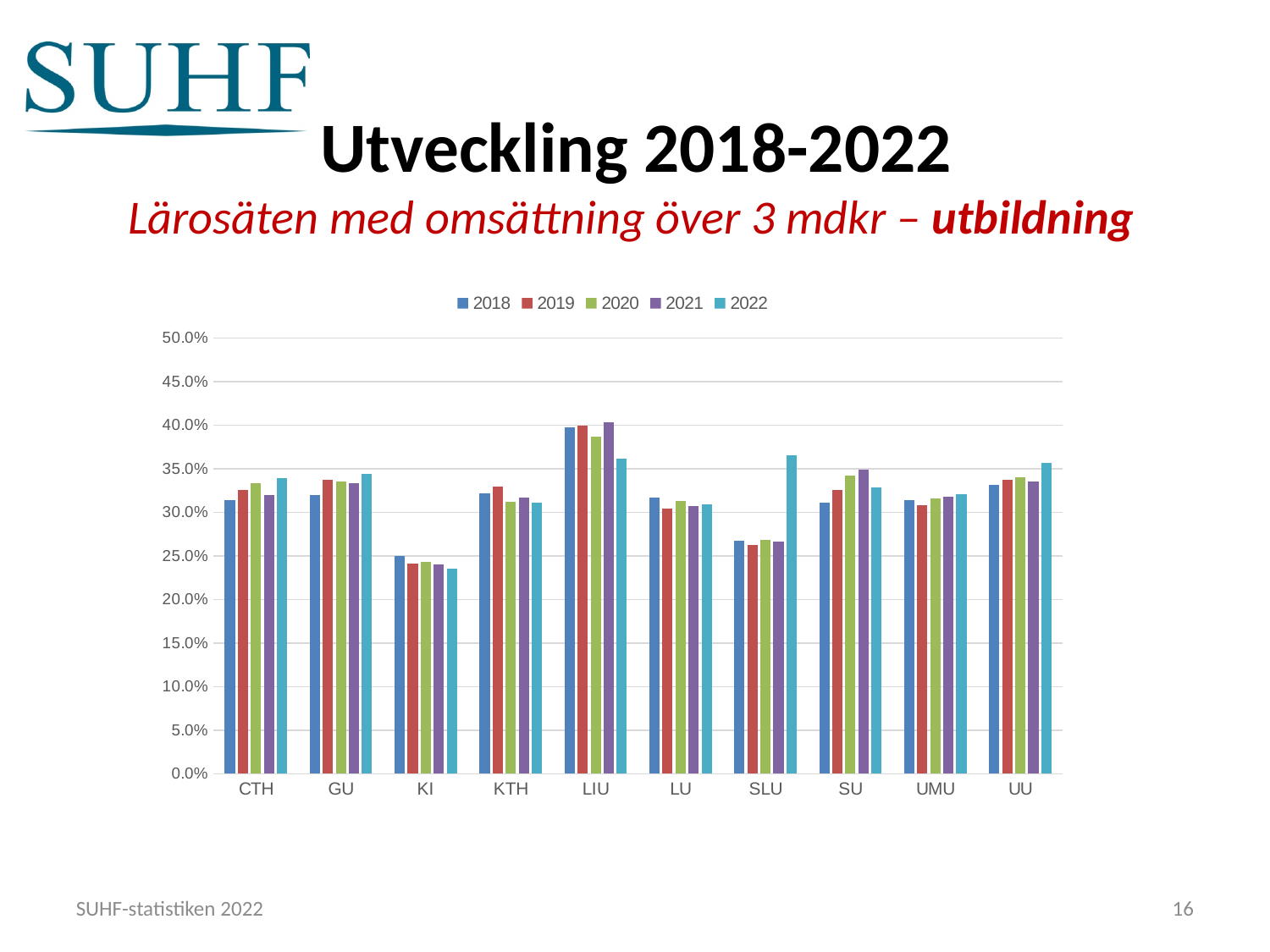
Do the bars for KI rise or fall from 2018 to 2022? fall Which institution has the highest values across the years? LIU Is the value for KI in 2022 greater or less than 25.0%? less Which is larger: the 2018 value for LIU or the 2018 value for KI? LIU How many series does the legend list? 5 How many institutions (categories) are shown on the x axis? 10 Which institution has the lowest values across the years? KI Is the value for SLU in 2022 greater or less than 35.0%? greater What kind of chart is shown on the slide? bar chart Is the value for CTH in 2018 greater or less than 30.0%? greater For SLU, which is larger: the 2021 value or the 2022 value? 2022